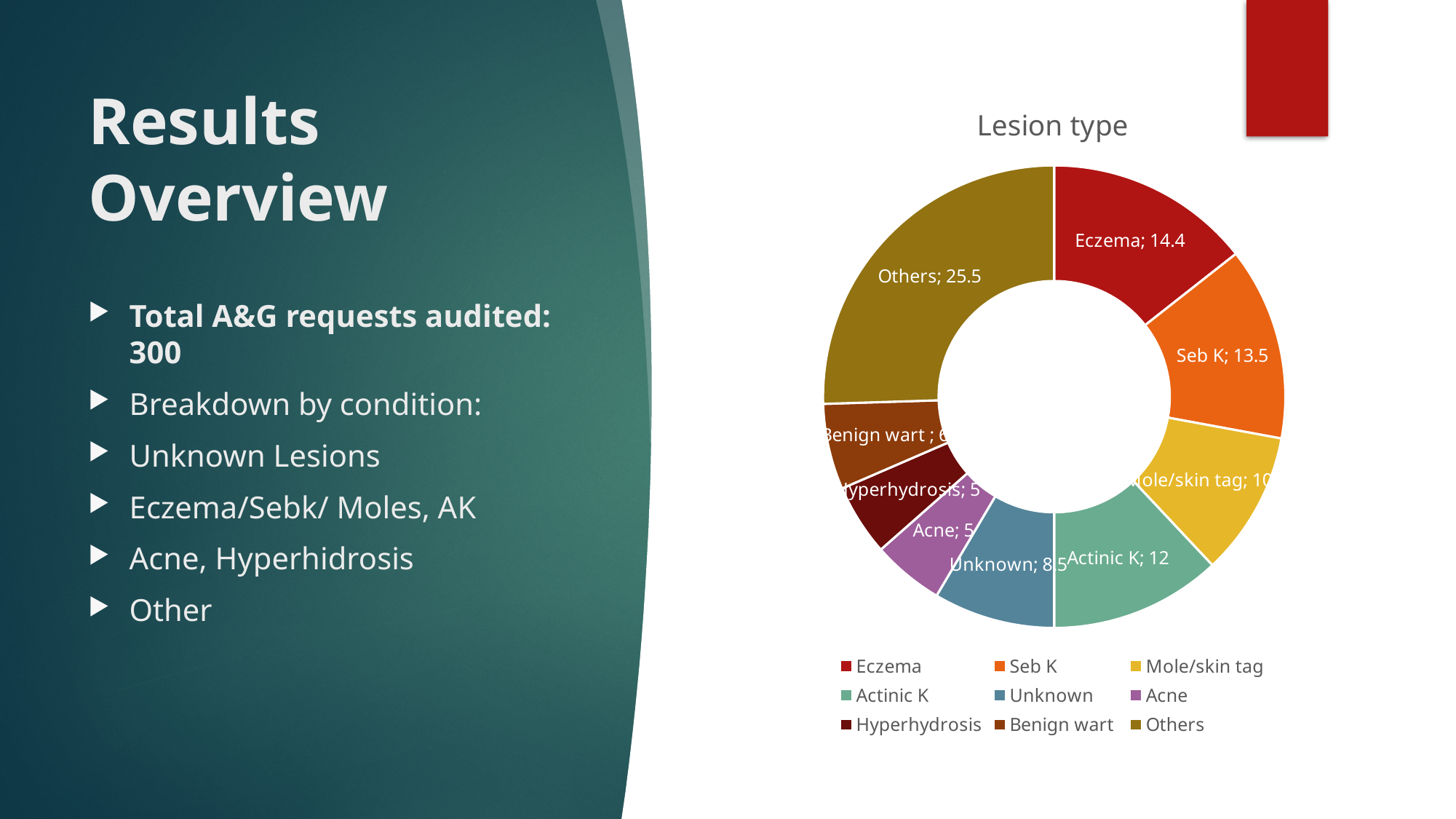
What kind of chart is the Lesion type chart? Doughnut (pie) chart What is the title of the chart on the slide? Lesion type How many categories are shown in the Lesion type chart? 9 Which is larger in the Lesion type chart, Actinic K or Unknown? Actinic K Which category has the largest value in the Lesion type chart? Others What is the value for Unknown in the Lesion type chart? 8.5 What is the value for Actinic K in the Lesion type chart? 12 What is the value for Seb K in the Lesion type chart? 13.5 What is the value for Others in the Lesion type chart? 25.5 What is the value for Eczema in the Lesion type chart? 14.4 What is the difference between the values for Others and Eczema in the Lesion type chart? 11.1 What is the difference between the values for Eczema and Seb K in the Lesion type chart? 0.9